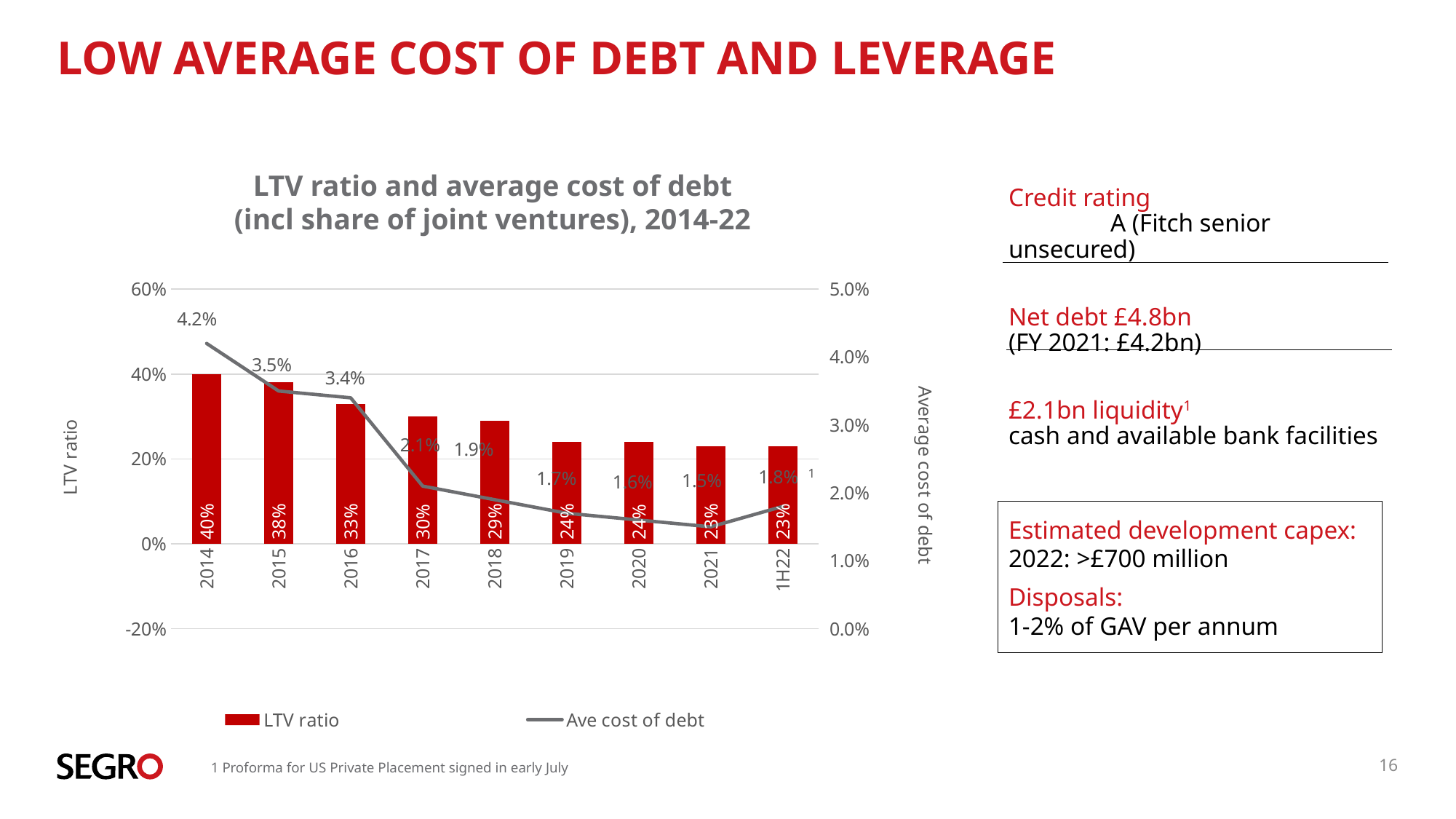
What is the LTV ratio for 1H22? 23% What is the LTV ratio for 2014? 40% How many periods are shown on the x axis? 9 How many series does the legend list? 2 What is the difference between the LTV ratio in 2014 and in 2018? 11% What is the average cost of debt for 2021? 1.5% What is the average cost of debt for 2017? 2.1% Which year has the highest LTV ratio? 2014 Which is larger, the average cost of debt in 2015 or in 2016? 2015 Which year has the lowest average cost of debt? 2021 What is the title of the chart? LTV ratio and average cost of debt (incl share of joint ventures), 2014-22 What is the overall trend of the average cost of debt from 2014 to 2021? Falling